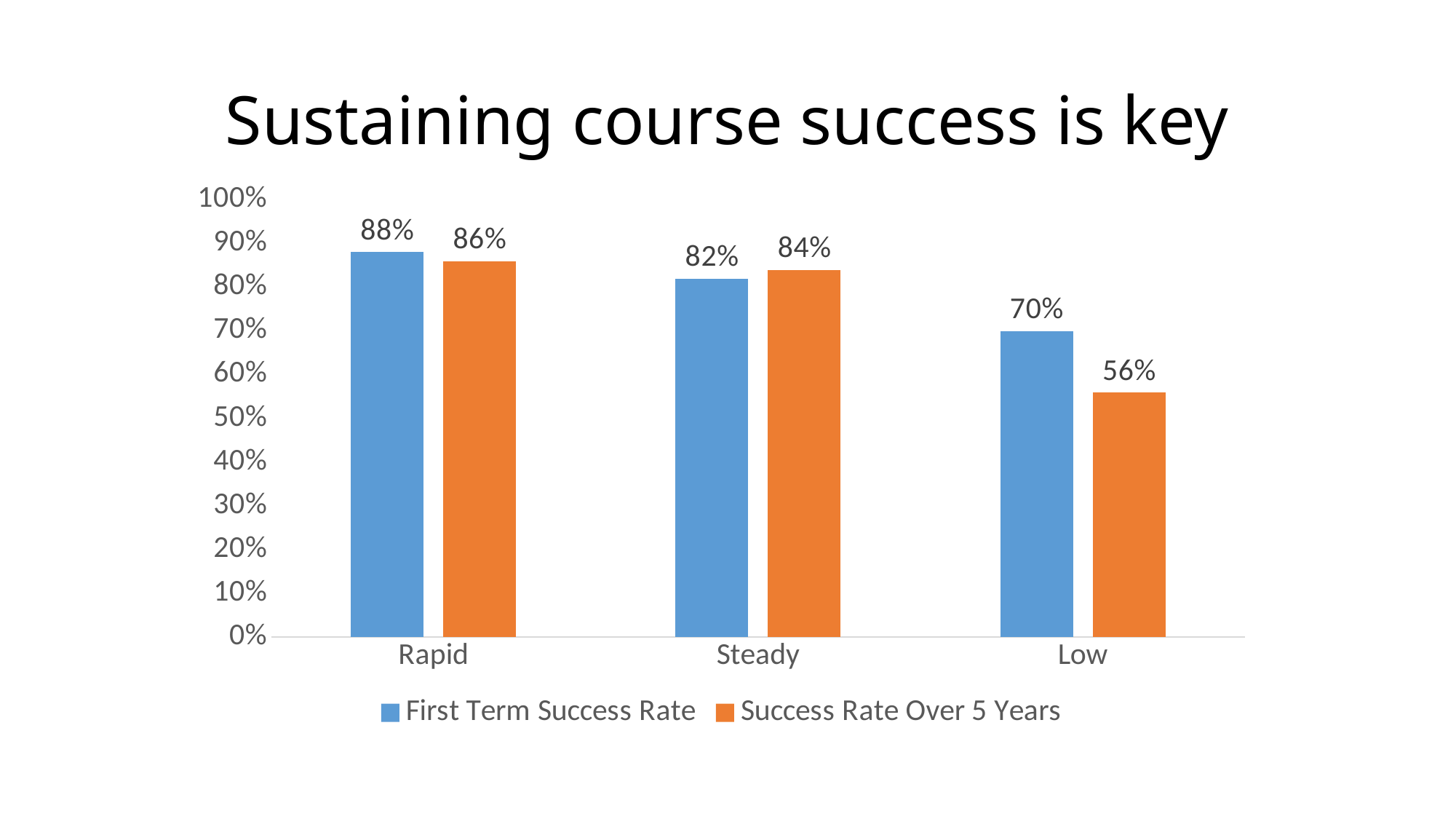
What is the Success Rate Over 5 Years for the Steady category? 84% Which category has the highest First Term Success Rate? Rapid What is the title of the slide? Sustaining course success is key What is the difference between the First Term Success Rate and the Success Rate Over 5 Years for the Low category? 14% Is the Success Rate Over 5 Years for the Low category greater or less than 60%? less What is the Success Rate Over 5 Years for the Low category? 56% How many series does the legend list? 2 What is the First Term Success Rate for the Rapid category? 88% For the Steady category, which is larger: the First Term Success Rate or the Success Rate Over 5 Years? Success Rate Over 5 Years What kind of chart is shown on the slide? bar chart Which category has the lowest Success Rate Over 5 Years? Low How many categories are shown on the x axis? 3